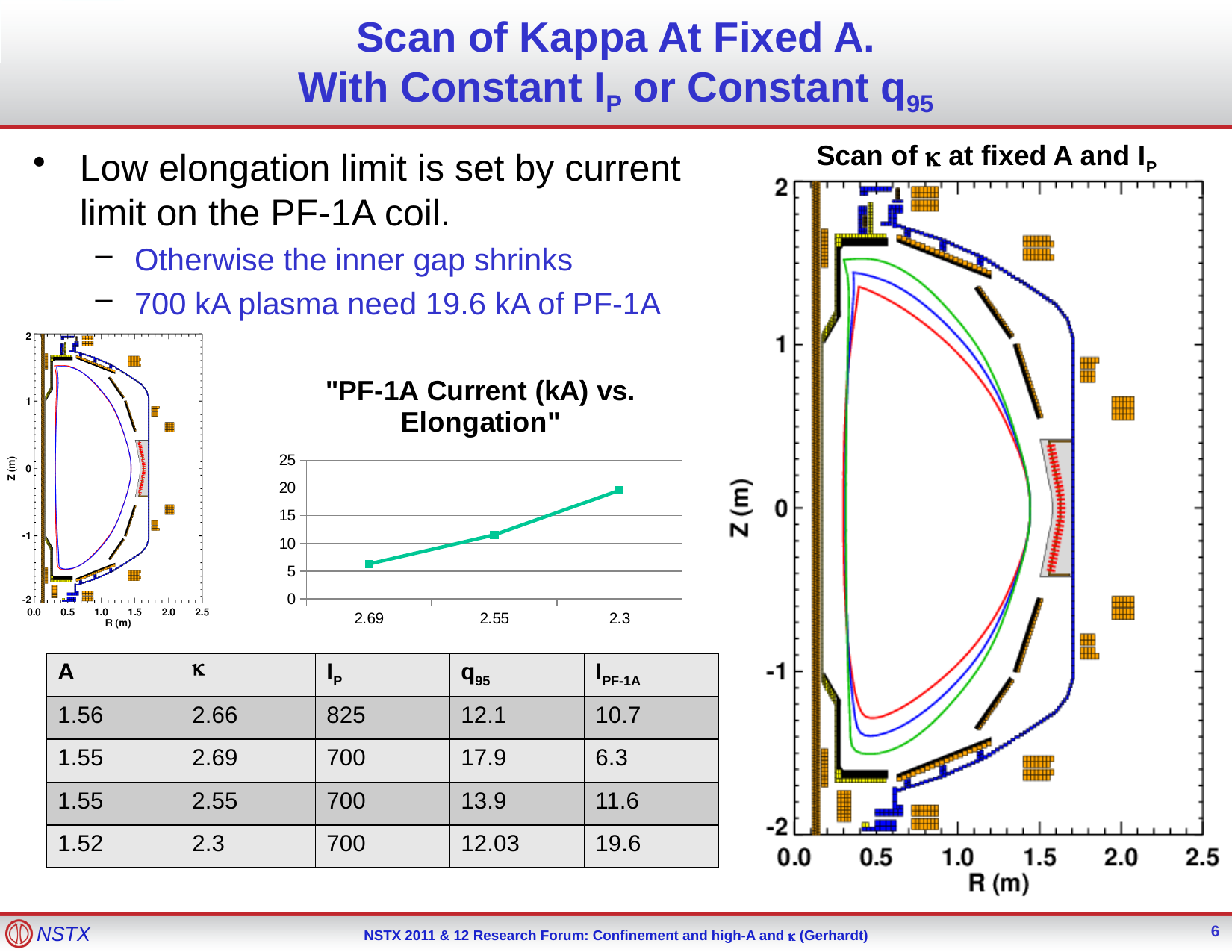
How many data points are plotted on the "PF-1A Current (kA) vs. Elongation" chart? 3 What is the title of the line chart in the middle of the slide? "PF-1A Current (kA) vs. Elongation" On the "PF-1A Current (kA) vs. Elongation" chart, is the value for elongation 2.69 greater or less than 10? less On the "PF-1A Current (kA) vs. Elongation" chart, do the values rise or fall from left to right along the x axis? rise What is the highest tick value shown on the y axis of the "PF-1A Current (kA) vs. Elongation" chart? 25 On the "PF-1A Current (kA) vs. Elongation" chart, is the value for elongation 2.3 greater or less than 15? greater On the "PF-1A Current (kA) vs. Elongation" chart, which has the larger PF-1A current: elongation 2.55 or elongation 2.69? 2.55 What kind of chart is the "PF-1A Current (kA) vs. Elongation" chart? line chart On the "PF-1A Current (kA) vs. Elongation" chart, which elongation category has the lowest PF-1A current? 2.69 On the "PF-1A Current (kA) vs. Elongation" chart, which elongation category has the highest PF-1A current? 2.3 On the "PF-1A Current (kA) vs. Elongation" chart, is the value for elongation 2.55 greater or less than 15? less